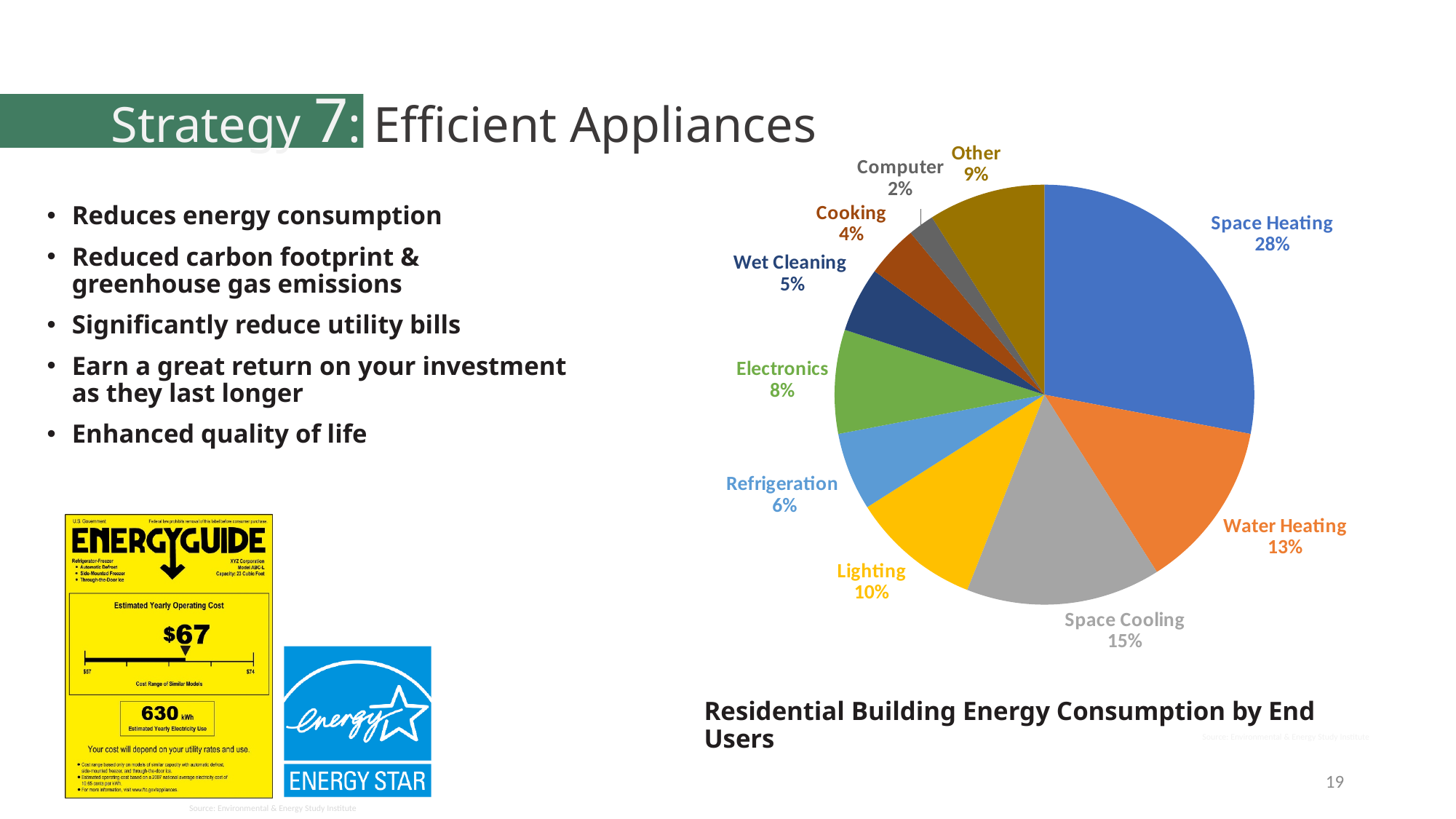
What is the title of the chart on the slide? Residential Building Energy Consumption by End Users What percentage of the pie is Water Heating? 13% What share of the pie is labelled Other? 9% How many categories are shown in the pie chart? 10 What is the difference in percentage points between Space Heating and Space Cooling? 13 What share of residential building energy consumption goes to Space Heating? 28% What kind of chart is used to show residential building energy consumption by end users? Pie chart What is the combined share of Wet Cleaning and Cooking? 9% Which end use has the largest share of residential building energy consumption? Space Heating Which is larger, the share for Electronics or the share for Refrigeration? Electronics Which end use has the smallest share in the pie chart? Computer What is the value shown for Lighting? 10%